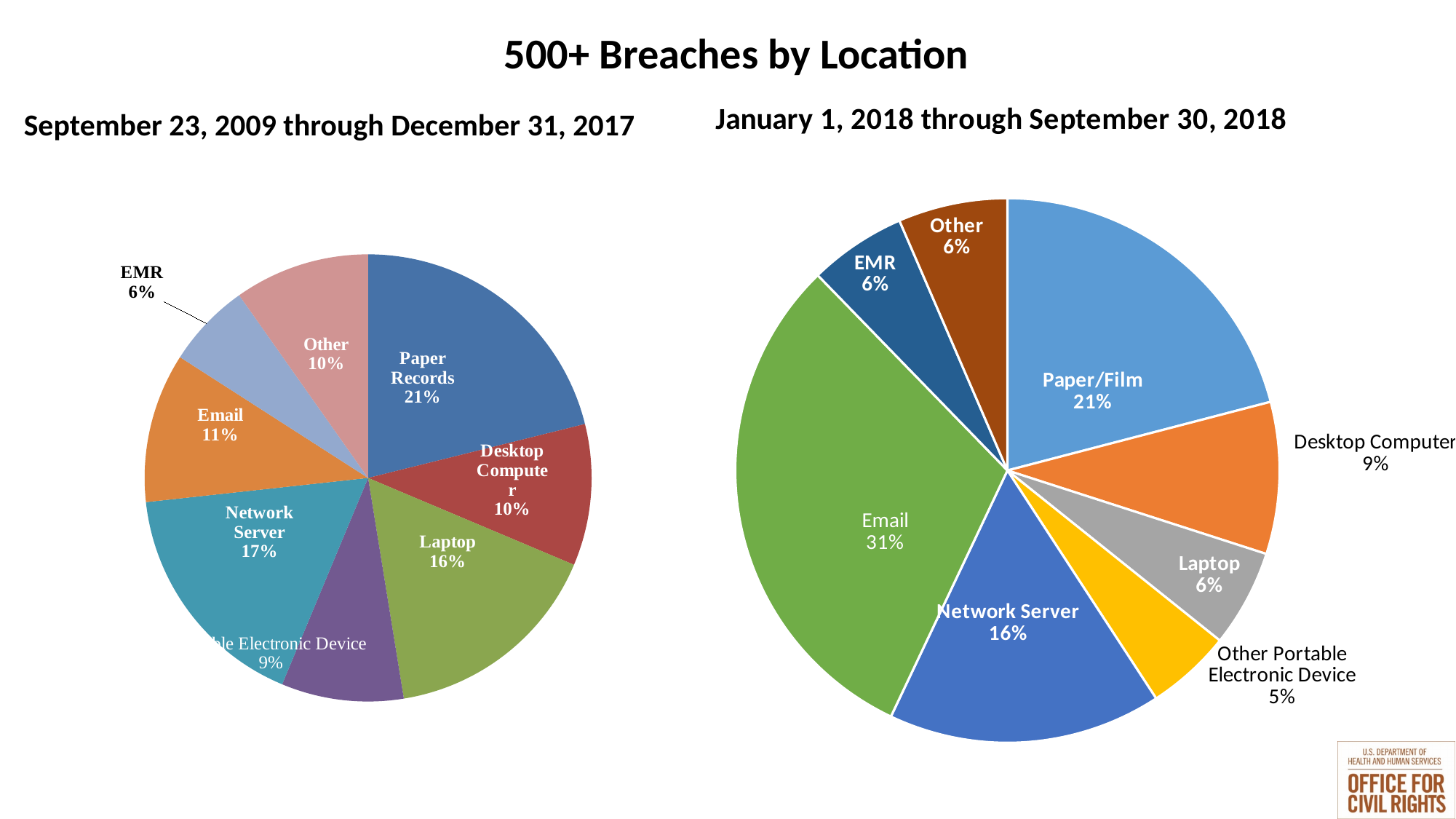
In the September 23, 2009 through December 31, 2017 pie chart, which location has the smallest share? EMR In the January 1, 2018 through September 30, 2018 pie chart, what percentage is shown for Other Portable Electronic Device? 5% How many slices does the January 1, 2018 through September 30, 2018 pie chart have? 8 In the January 1, 2018 through September 30, 2018 pie chart, which is larger: Network Server or Desktop Computer? Network Server What is the difference in percentage points between Email in the 2018 pie chart and Email in the 2009–2017 pie chart? 20 percentage points In the January 1, 2018 through September 30, 2018 pie chart, which location has the largest share? Email In the September 23, 2009 through December 31, 2017 pie chart, what percentage is shown for Paper Records? 21% What type of chart is used on this slide? Pie chart In the January 1, 2018 through September 30, 2018 pie chart, which location has the smallest share? Other Portable Electronic Device In the January 1, 2018 through September 30, 2018 pie chart, what share of breaches is attributed to Email? 31% In the September 23, 2009 through December 31, 2017 pie chart, what share of breaches is attributed to Network Server? 17% In the September 23, 2009 through December 31, 2017 pie chart, which location has the largest share? Paper Records